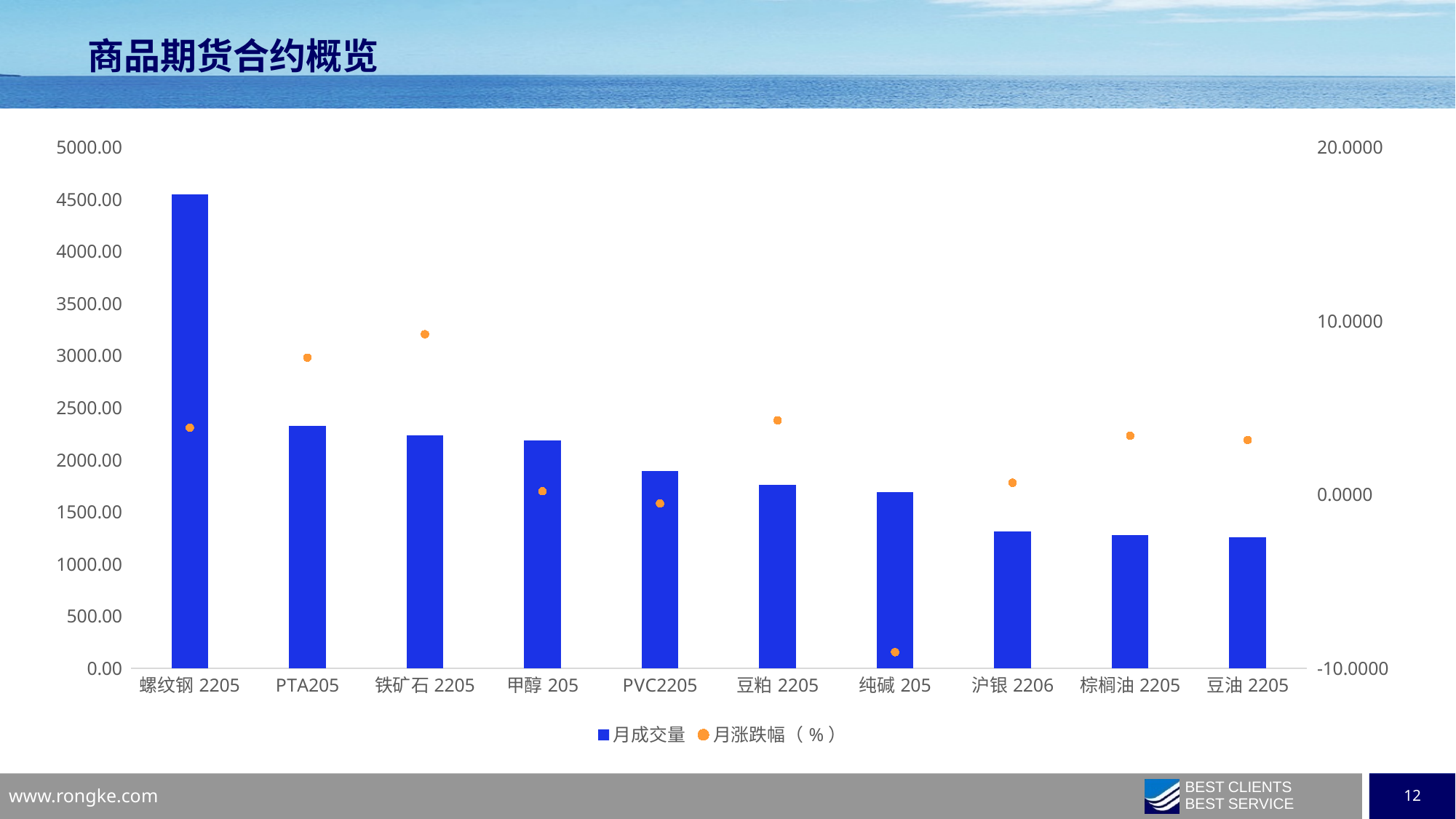
Which has the larger 月成交量 bar, PVC2205 or 豆粕 2205? PVC2205 How many series does the legend list? 2 What is the title of the slide? 商品期货合约概览 Which contract has the highest 月成交量 bar? 螺纹钢 2205 How many contract categories are shown on the x axis? 10 Is the 月成交量 bar for 螺纹钢 2205 greater or less than 4000.00? greater Which contract has the highest 月涨跌幅（%） dot? 铁矿石 2205 What kind of chart is shown on the slide? A combination chart of bars and dots (bar chart with a dot series) Which contract has the lowest 月涨跌幅（%） dot? 纯碱 205 Do the 月成交量 bars generally rise or fall from left to right along the x axis? fall Is the 月成交量 bar for 沪银 2206 greater or less than 1500.00? less Is the 月涨跌幅（%） value for 纯碱 205 greater or less than 0.0000? less